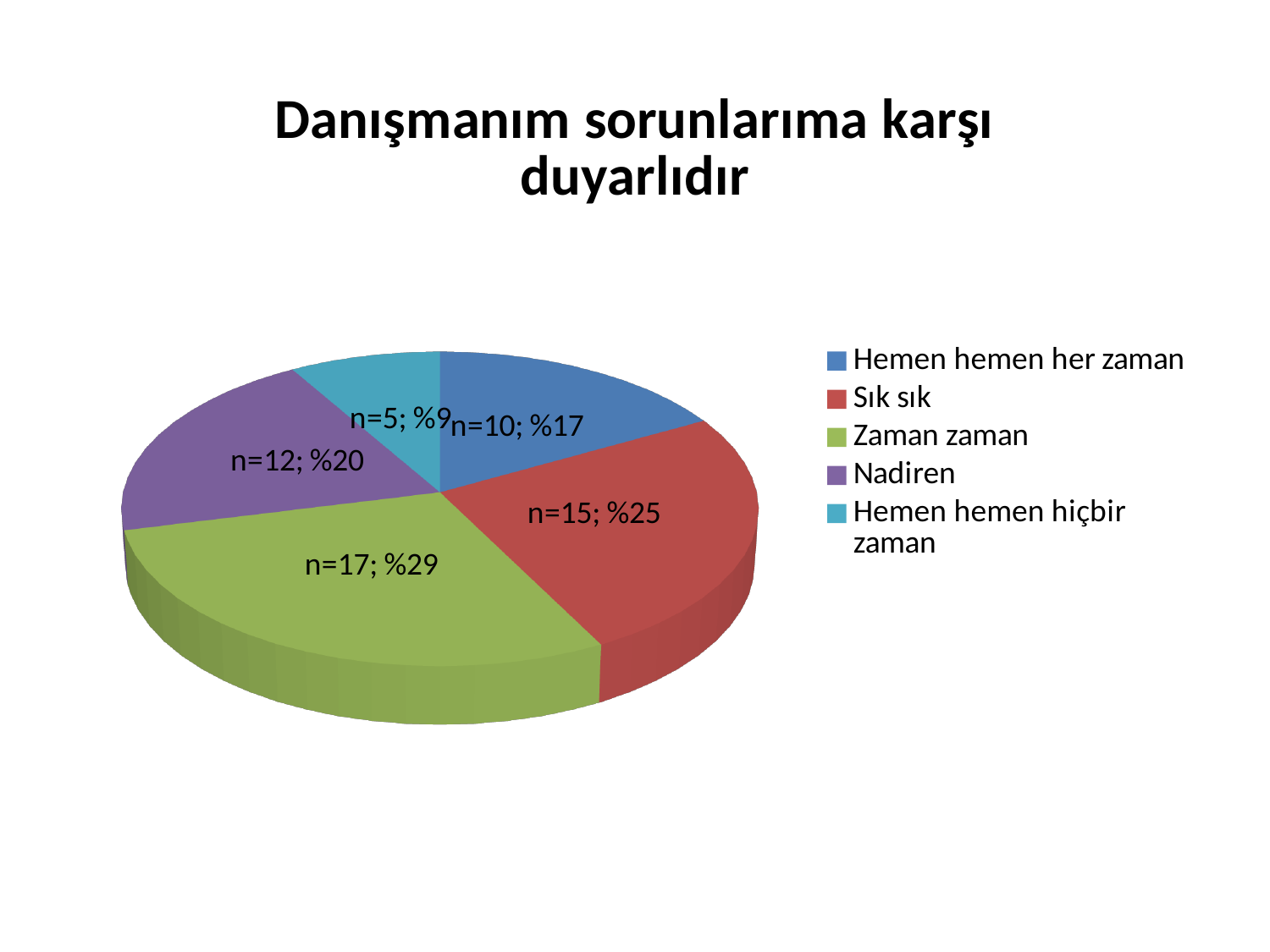
What is the difference in n between 'Zaman zaman' and 'Hemen hemen hiçbir zaman'? 12 Which category has the largest slice? Zaman zaman What colour is the 'Nadiren' slice? Purple What is the data label for the 'Zaman zaman' slice? n=17; %29 Which category has the smallest slice? Hemen hemen hiçbir zaman What percentage share does 'Nadiren' have? %20 How many categories does the legend list? 5 Which is larger, the slice for 'Sık sık' or the slice for 'Nadiren'? Sık sık What is the n value for 'Sık sık'? 15 What is the title of the chart? Danışmanım sorunlarıma karşı duyarlıdır What percentage share does 'Hemen hemen her zaman' have? %17 What kind of chart is shown on the slide? Pie chart